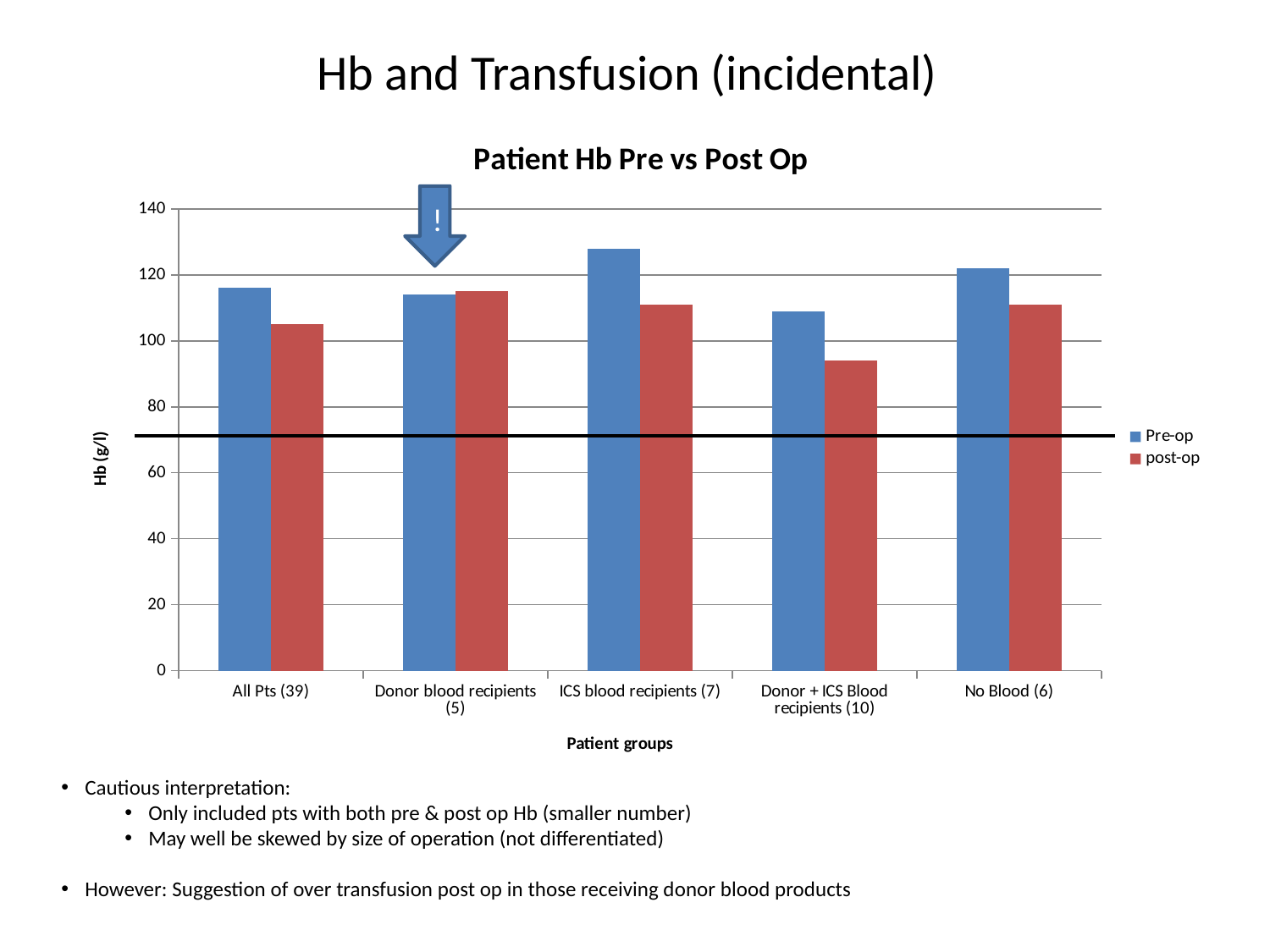
How many patient groups are shown on the x axis of the chart? 5 What kind of chart is shown on the slide? bar chart Is the post-op value for Donor + ICS Blood recipients (10) greater or less than 100? less How many series does the chart legend list? 2 For ICS blood recipients (7), which is larger, the Pre-op value or the post-op value? Pre-op Which patient group has the highest Pre-op Hb value? ICS blood recipients (7) What is the title of the chart? Patient Hb Pre vs Post Op What is the label on the vertical axis of the chart? Hb (g/l) Is the Pre-op value for ICS blood recipients (7) greater or less than 120? greater For All Pts (39), which is larger, the Pre-op value or the post-op value? Pre-op Which patient group has the lowest Pre-op Hb value? Donor + ICS Blood recipients (10) Which patient group has the lowest post-op Hb value? Donor + ICS Blood recipients (10)